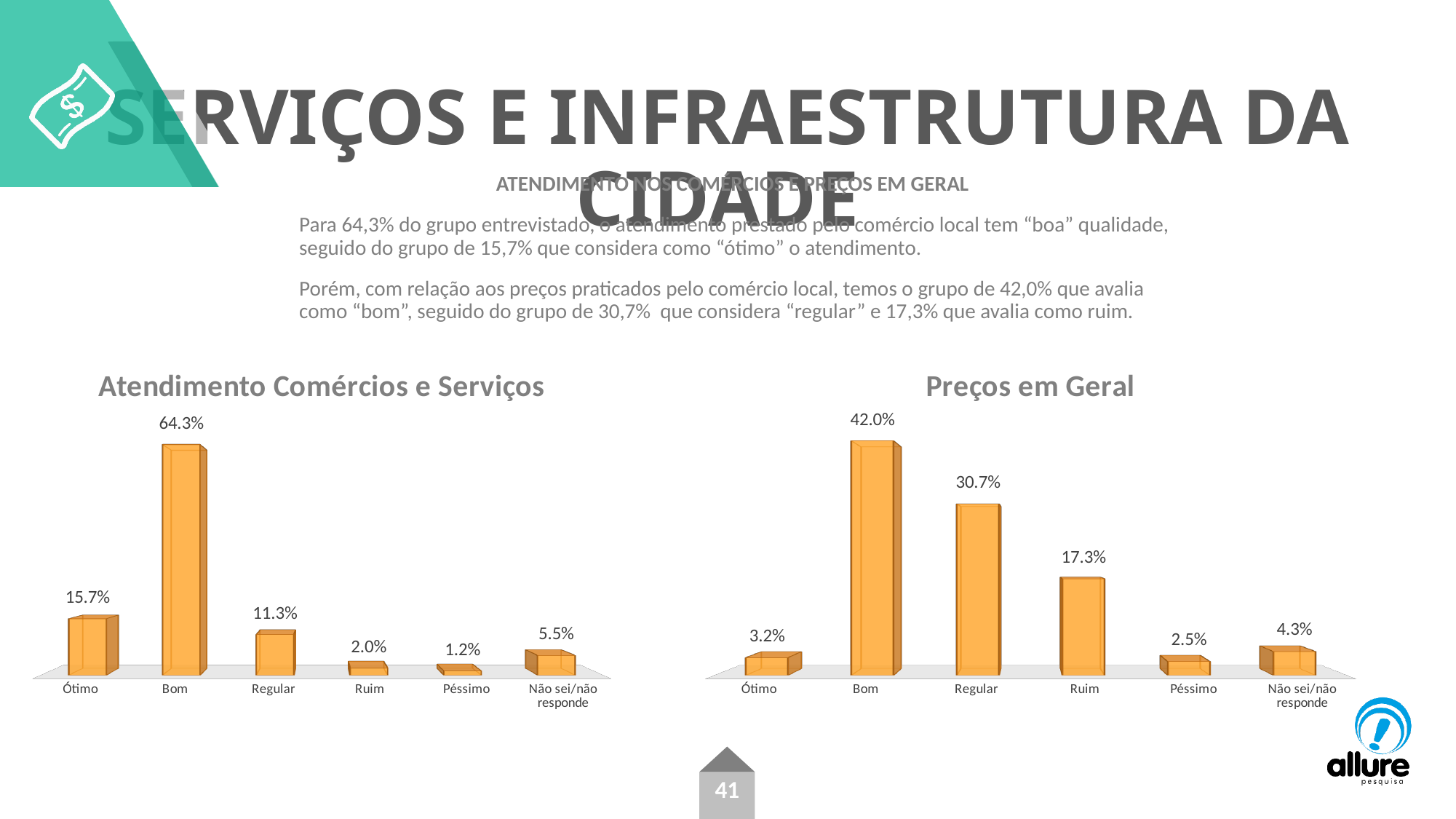
What is the title of the chart on the right side of the slide? Preços em Geral In the 'Preços em Geral' chart, what is the value for Regular? 30.7% In the 'Preços em Geral' chart, what is the difference between Bom and Regular? 11.3% In the 'Atendimento Comércios e Serviços' chart, what is the value for Bom? 64.3% How many categories are shown in the 'Preços em Geral' chart? 6 What kind of chart is 'Atendimento Comércios e Serviços'? Bar chart In the 'Atendimento Comércios e Serviços' chart, which category has the lowest value? Péssimo In the 'Preços em Geral' chart, what is the value for Não sei/não responde? 4.3% In the 'Preços em Geral' chart, which is larger, Ótimo or Péssimo? Ótimo In the 'Preços em Geral' chart, which category has the highest value? Bom In the 'Atendimento Comércios e Serviços' chart, which is larger, Ótimo or Regular? Ótimo In the 'Atendimento Comércios e Serviços' chart, what is the difference between Ótimo and Regular? 4.4%